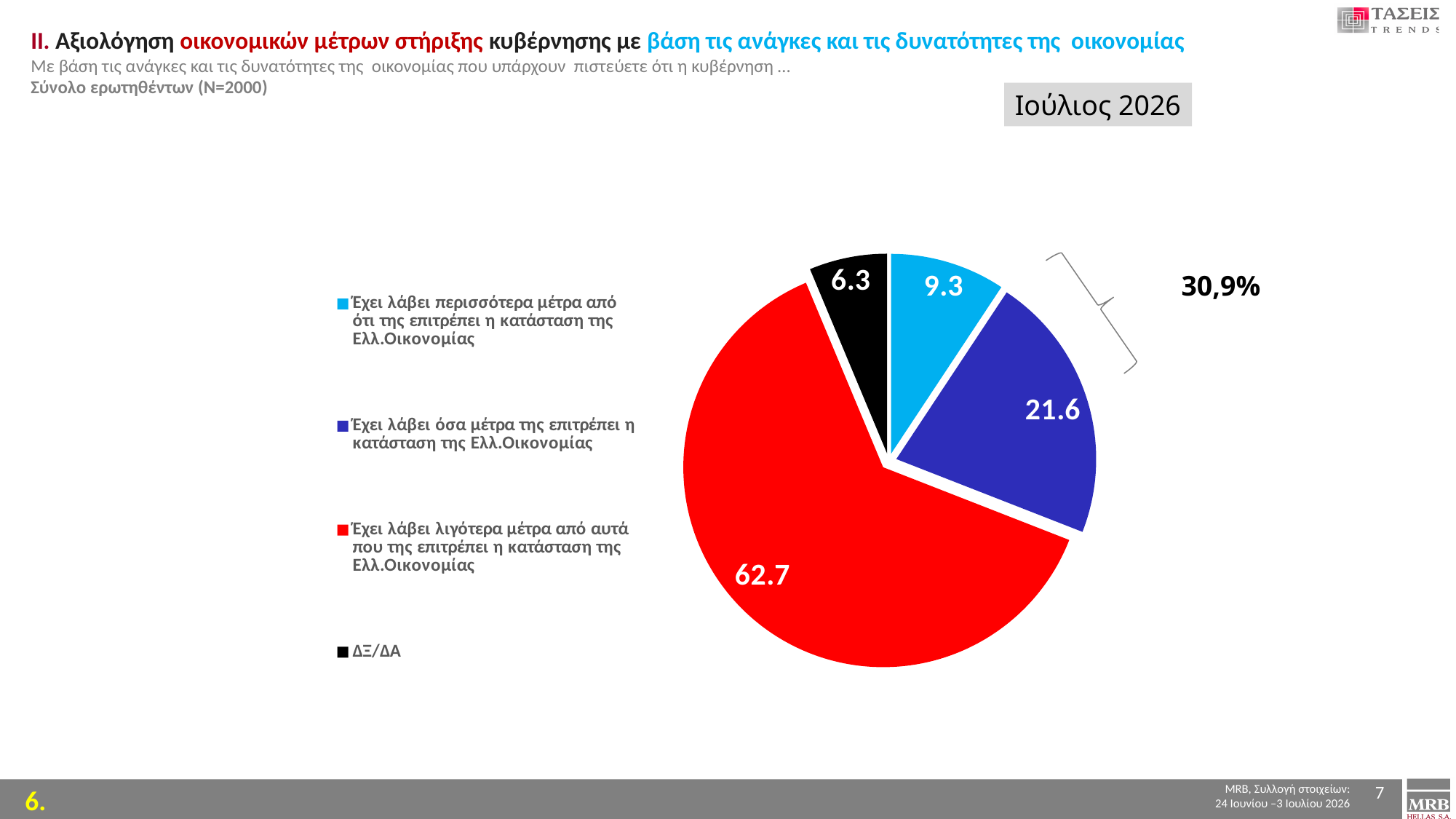
What is the value for 'Έχει λάβει περισσότερα μέτρα από ότι της επιτρέπει η κατάσταση της Ελλ.Οικονομίας'? 9.3 How many slices does the pie chart have? 4 What colour is the slice for 'ΔΞ/ΔΑ'? black What type of chart is shown on the slide? pie chart What combined percentage is shown by the bracket next to the light blue and blue slices? 30,9% What is the value for 'ΔΞ/ΔΑ'? 6.3 What is the value for 'Έχει λάβει λιγότερα μέτρα από αυτά που της επιτρέπει η κατάσταση της Ελλ.Οικονομίας'? 62.7 What is the value for 'Έχει λάβει όσα μέτρα της επιτρέπει η κατάσταση της Ελλ.Οικονομίας'? 21.6 Which is larger: the value for 'Έχει λάβει περισσότερα μέτρα' or the value for 'ΔΞ/ΔΑ'? Έχει λάβει περισσότερα μέτρα What is the difference between the value for 'Έχει λάβει λιγότερα μέτρα' and the value for 'Έχει λάβει όσα μέτρα'? 41.1 Which category has the largest slice of the pie? Έχει λάβει λιγότερα μέτρα από αυτά που της επιτρέπει η κατάσταση της Ελλ.Οικονομίας Which category has the smallest slice of the pie? ΔΞ/ΔΑ